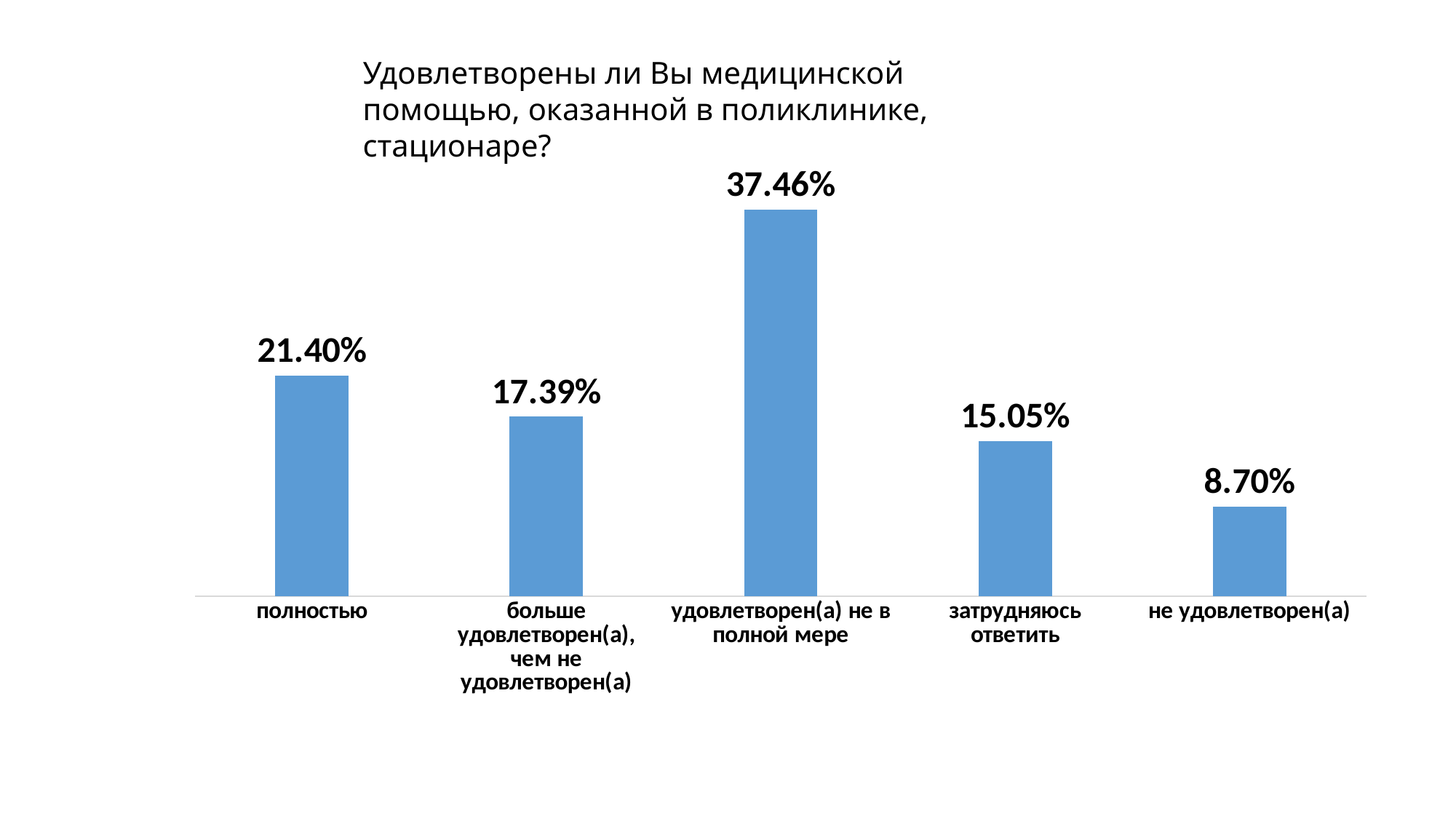
What is the value for "полностью"? 21.40% What is the value for "удовлетворен(а) не в полной мере"? 37.46% Which category has the lowest value? не удовлетворен(а) Which category has the highest value? удовлетворен(а) не в полной мере What is the value for "больше удовлетворен(а), чем не удовлетворен(а)"? 17.39% What is the value for "не удовлетворен(а)"? 8.70% What is the title of the chart? Удовлетворены ли Вы медицинской помощью, оказанной в поликлинике, стационаре? Which is larger, the value for "полностью" or the value for "затрудняюсь ответить"? полностью How many categories are shown in the chart? 5 What is the difference between the values for "полностью" and "не удовлетворен(а)"? 12.70% What is the value for "затрудняюсь ответить"? 15.05% What kind of chart is shown on the slide? bar chart